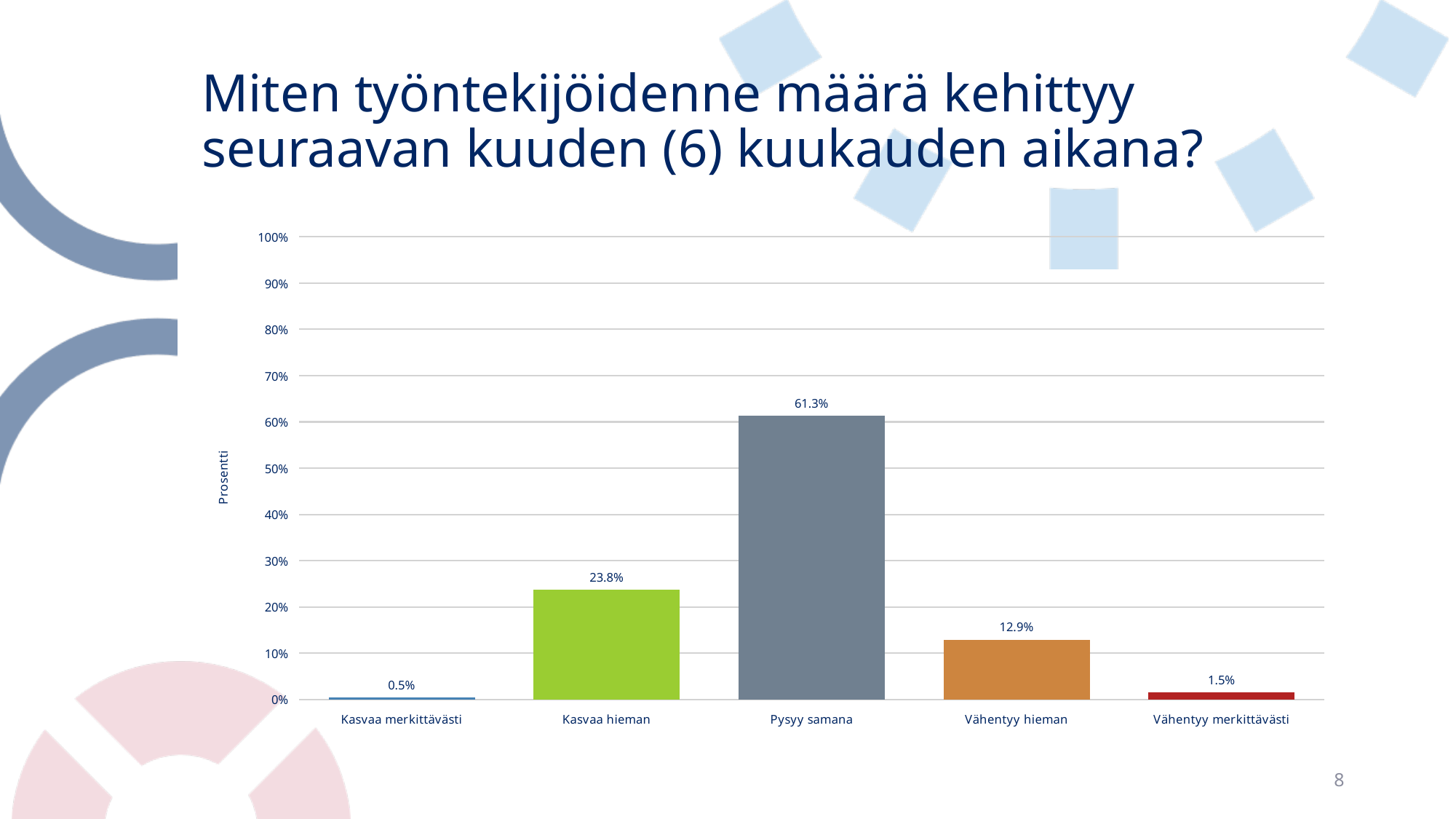
What is the value for Kasvaa hieman? 23.8% What is the value for Pysyy samana? 61.3% Which category has the highest value? Pysyy samana What is the difference between the values for Pysyy samana and Kasvaa hieman? 37.5% What kind of chart is shown on the slide? bar chart What is the value for Vähentyy merkittävästi? 1.5% What is the difference between the values for Vähentyy hieman and Vähentyy merkittävästi? 11.4% Which is larger, the value for Kasvaa hieman or the value for Vähentyy hieman? Kasvaa hieman How many categories are shown on the x axis? 5 Which category has the lowest value? Kasvaa merkittävästi Is the value for Pysyy samana greater or less than 50%? greater What is the label of the vertical axis? Prosentti